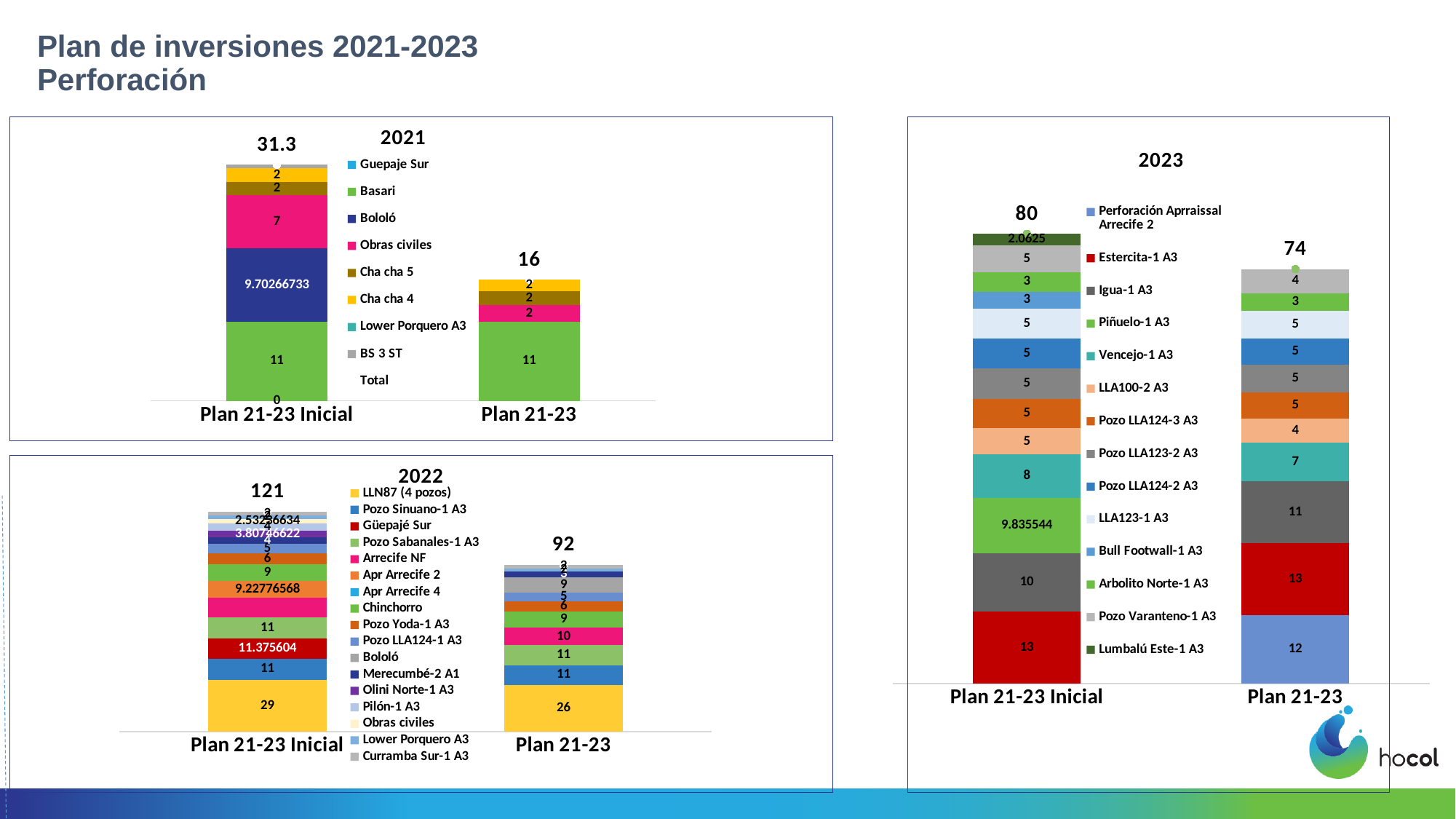
In the 2021 chart, what is the total for the Plan 21-23 bar? 16 In the 2022 chart, what is the total for the Plan 21-23 Inicial bar? 121 In the 2021 chart, what is the value of Bololó in the Plan 21-23 Inicial bar? 9.70266733 How many bars (categories) does the 2021 chart show? 2 In the 2023 chart, which bar has the higher total, Plan 21-23 Inicial or Plan 21-23? Plan 21-23 Inicial In the 2023 chart, what is the value of Estercita-1 A3 in the Plan 21-23 bar? 13 In the 2023 chart, what is the value of Piñuelo-1 A3 in the Plan 21-23 Inicial bar? 9.835544 In the 2023 chart, what is the difference between the totals of the Plan 21-23 Inicial bar and the Plan 21-23 bar? 6 In the 2022 chart, what is the difference between the totals of the Plan 21-23 Inicial bar and the Plan 21-23 bar? 29 What kind of chart is the 2023 chart? Stacked bar chart In the 2021 chart, what is the total for the Plan 21-23 Inicial bar? 31.3 In the 2022 chart, what is the value of LLN87 (4 pozos) in the Plan 21-23 bar? 26